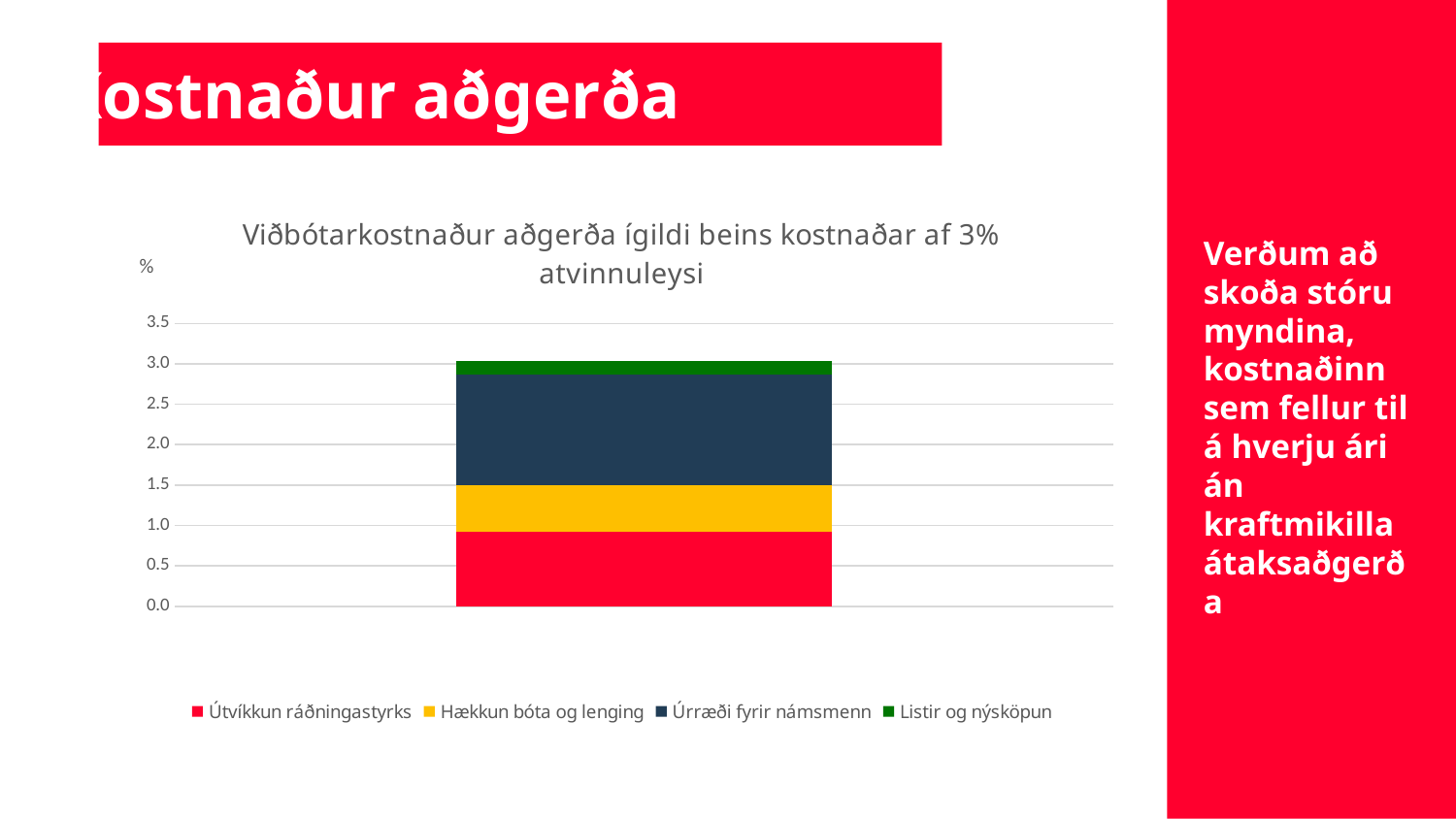
Which series forms the largest segment of the stacked bar? Úrræði fyrir námsmenn Is the value for Útvíkkun ráðningastyrks greater or less than 0.5? greater Which segment is larger: Útvíkkun ráðningastyrks or Hækkun bóta og lenging? Útvíkkun ráðningastyrks What colour represents Listir og nýsköpun in the legend? green Which series forms the smallest segment of the stacked bar? Listir og nýsköpun What is the title of the chart? Viðbótarkostnaður aðgerða ígildi beins kostnaðar af 3% atvinnuleysi Is the total height of the stacked bar greater or less than 2.5? greater How many series does the legend list? 4 What kind of chart is shown on the slide? bar chart How many bars are plotted in the chart? 1 Is the total height of the stacked bar greater or less than 3.5? less